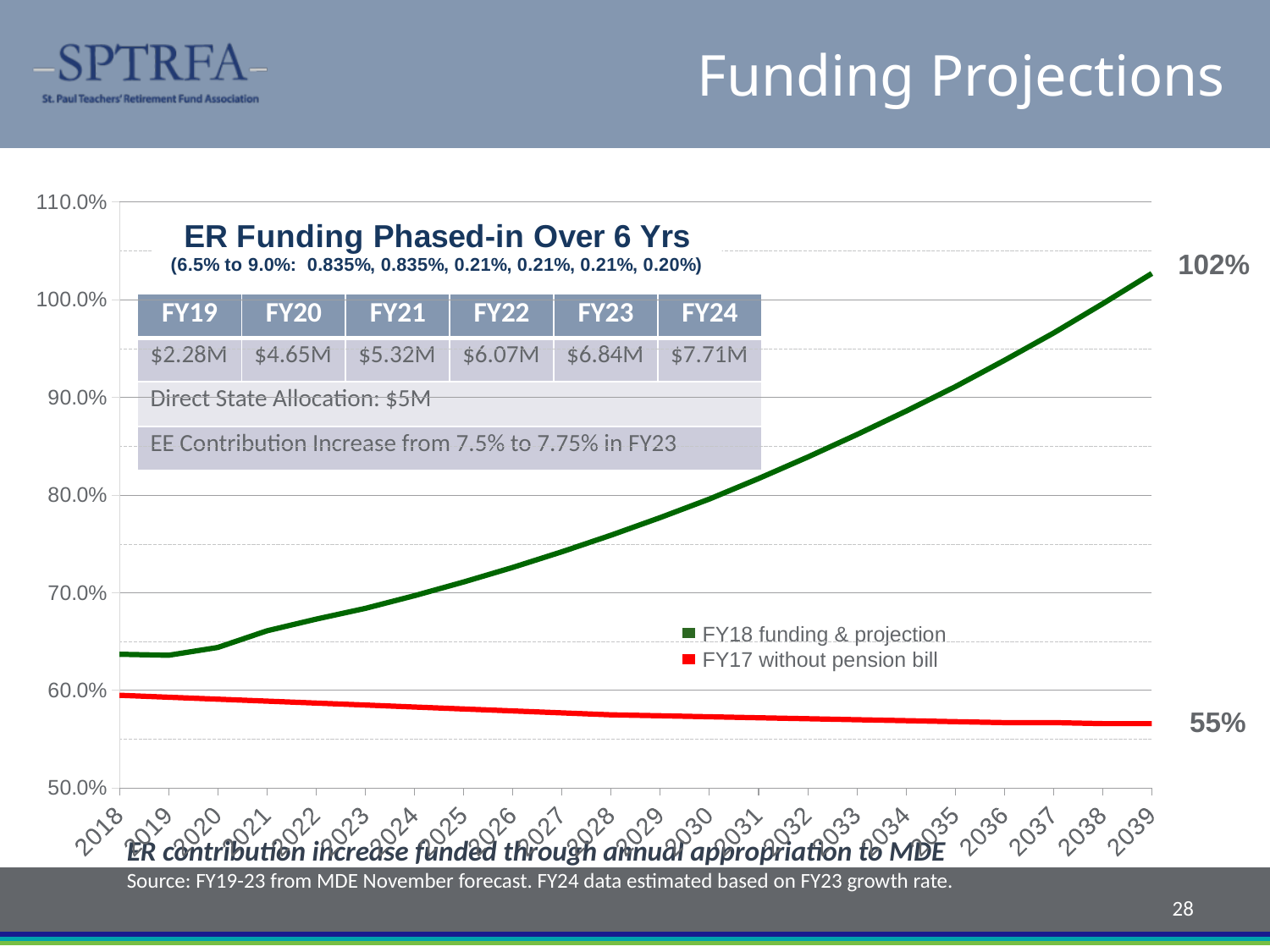
What is the value of the FY18 funding & projection series in 2039? 102% What is the value of the FY17 without pension bill series in 2039? 55% In 2039, which series has the higher value: FY18 funding & projection or FY17 without pension bill? FY18 funding & projection Is the value for FY18 funding & projection in 2030 greater or less than 70%? greater What is the difference between the FY18 funding & projection value and the FY17 without pension bill value in 2039? 47% How many series does the chart legend list? 2 What colour is the FY17 without pension bill line in the chart? red Is the value for FY17 without pension bill in 2030 greater or less than 60%? less How many years are shown along the x axis of the chart? 22 Does the FY17 without pension bill line rise or fall from 2018 to 2039? fall What kind of chart is shown on the slide? line chart Does the FY18 funding & projection line rise or fall from 2018 to 2039? rise